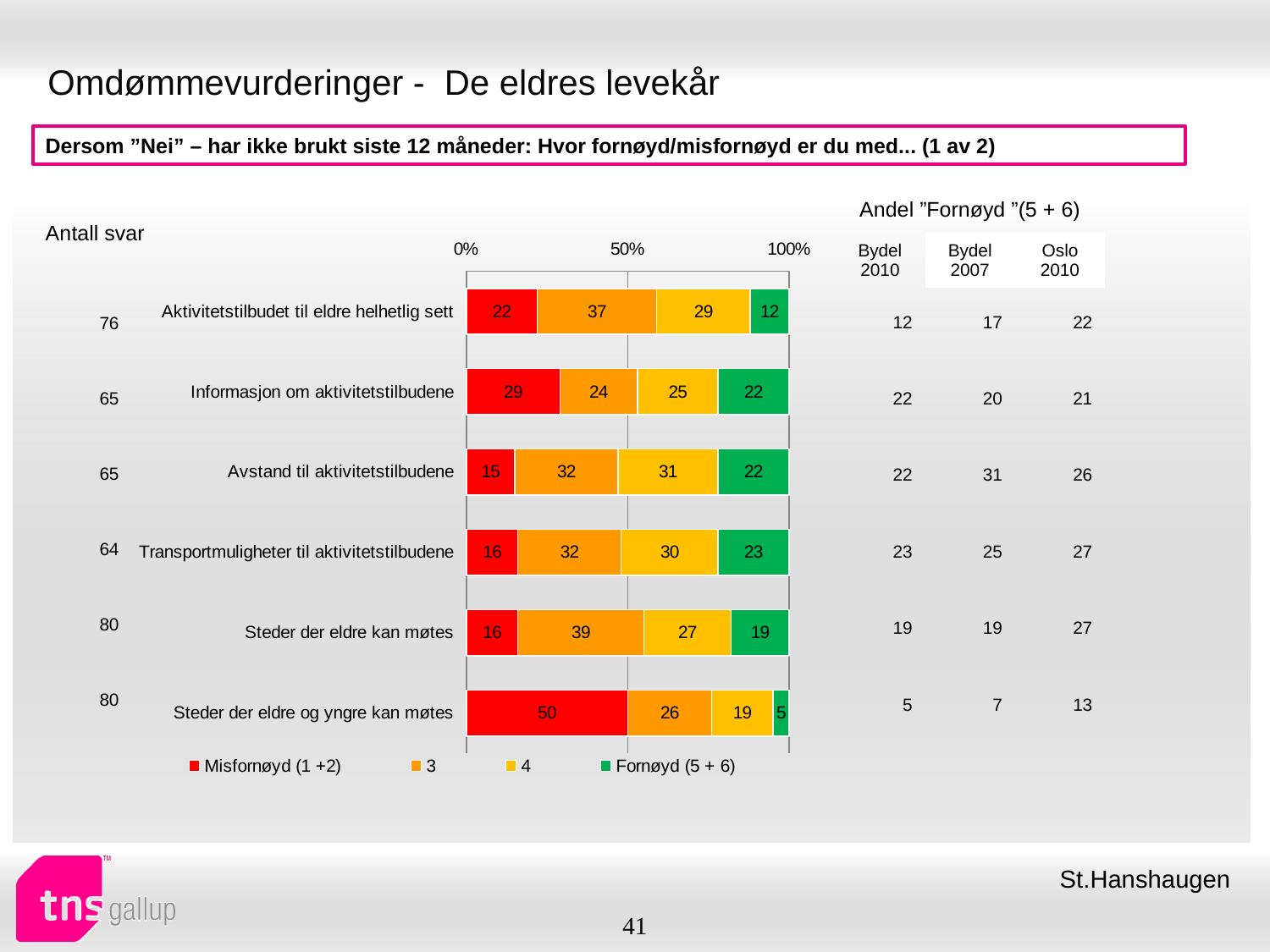
Which category has the highest Misfornøyd (1 +2) value? Steder der eldre og yngre kan møtes What is the difference between the Misfornøyd (1 +2) values for 'Informasjon om aktivitetstilbudene' and 'Avstand til aktivitetstilbudene'? 14 What is the Fornøyd (5 + 6) value for 'Transportmuligheter til aktivitetstilbudene'? 23 What is the total of the stacked bar for 'Aktivitetstilbudet til eldre helhetlig sett'? 100 How many categories are plotted in the chart? 6 What kind of chart is shown on the slide? Stacked bar chart Which colour represents the Fornøyd (5 + 6) series in the chart? Green Which category has the lowest Fornøyd (5 + 6) value? Steder der eldre og yngre kan møtes What is the value of series '3' for 'Steder der eldre kan møtes'? 39 Which is larger: the Fornøyd (5 + 6) value for 'Aktivitetstilbudet til eldre helhetlig sett' or for 'Informasjon om aktivitetstilbudene'? Informasjon om aktivitetstilbudene What is the Misfornøyd (1 +2) value for 'Steder der eldre og yngre kan møtes'? 50 How many series does the chart legend list? 4